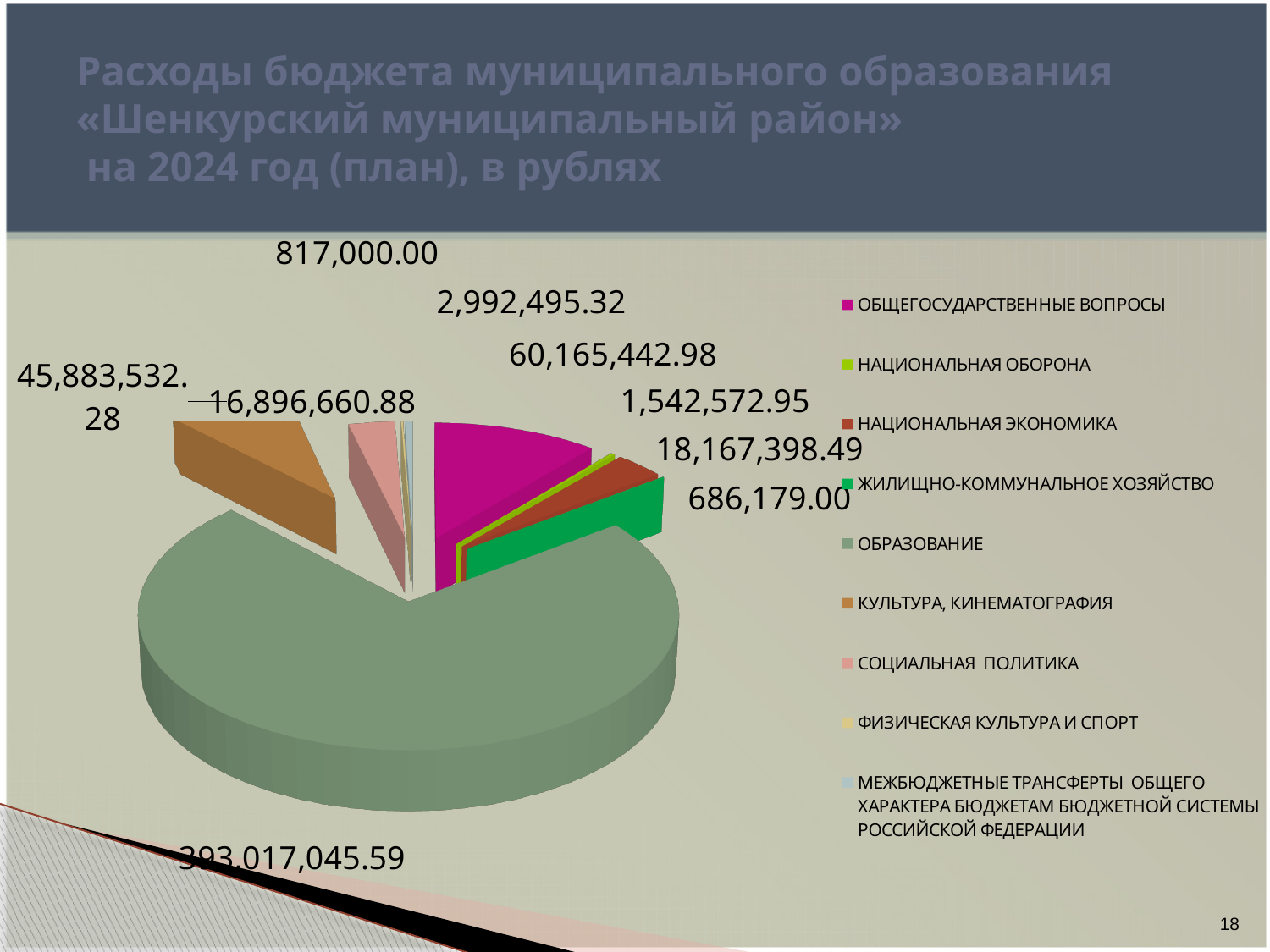
What is the smallest data label value shown on the pie chart? 686,179.00 What kind of chart is shown on the slide? Pie chart Which is larger, the value for ОБРАЗОВАНИЕ or the value for КУЛЬТУРА, КИНЕМАТОГРАФИЯ? ОБРАЗОВАНИЕ What is the value shown for ОБРАЗОВАНИЕ? 393,017,045.59 Which category has the largest share of the pie chart? ОБРАЗОВАНИЕ What is the value shown for КУЛЬТУРА, КИНЕМАТОГРАФИЯ? 45,883,532.28 Which year does the slide title say the planned budget expenditures are for? 2024 How many categories does the legend of the pie chart list? 9 What is the difference between the values for ОБРАЗОВАНИЕ and КУЛЬТУРА, КИНЕМАТОГРАФИЯ? 347,133,513.31 What is the difference between the values for КУЛЬТУРА, КИНЕМАТОГРАФИЯ and СОЦИАЛЬНАЯ ПОЛИТИКА? 28,986,871.40 What is the value shown for ОБЩЕГОСУДАРСТВЕННЫЕ ВОПРОСЫ? 60,165,442.98 What is the value shown for СОЦИАЛЬНАЯ ПОЛИТИКА? 16,896,660.88